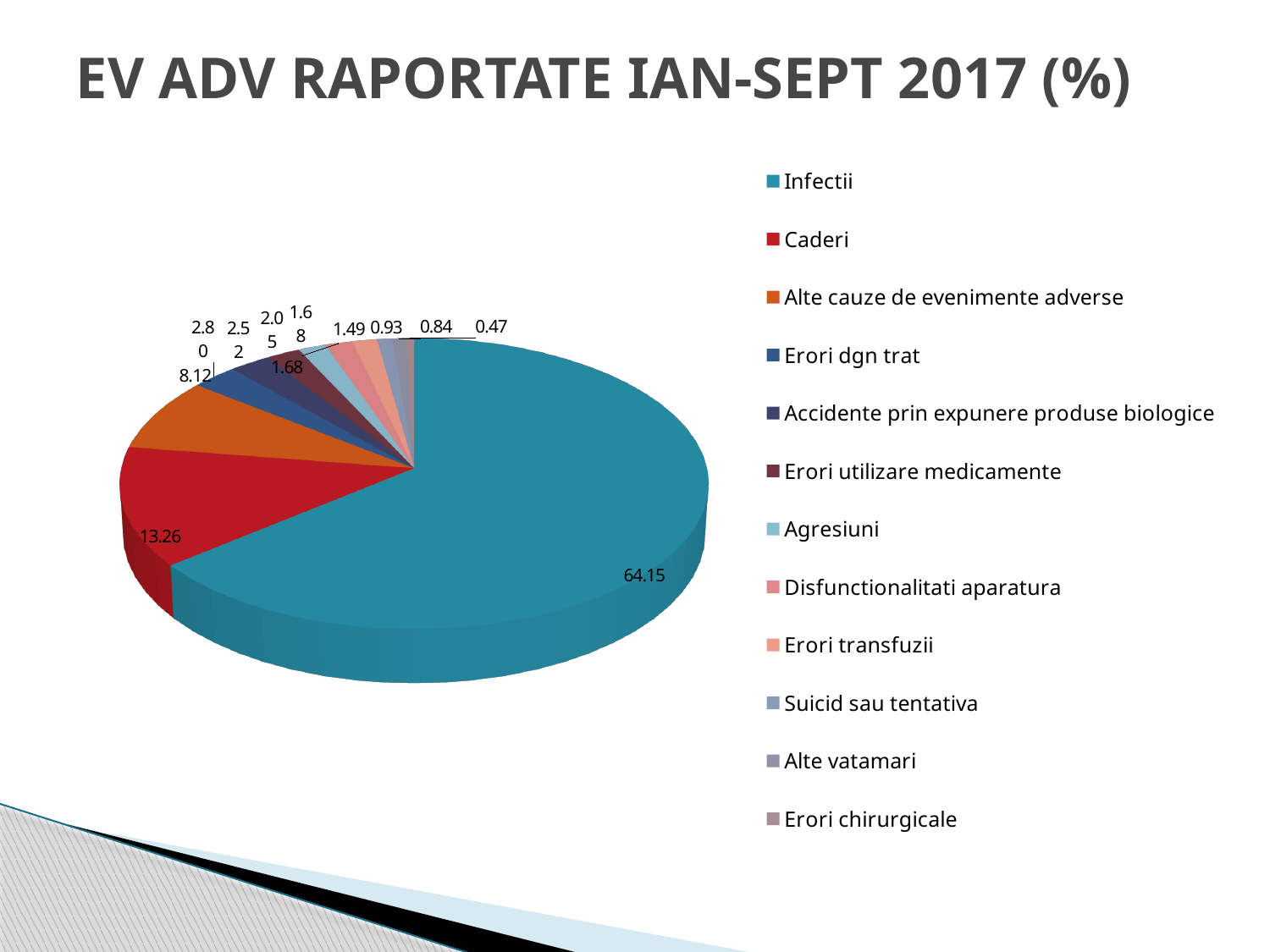
How many categories does the legend list? 12 What is the title of the chart? EV ADV RAPORTATE IAN-SEPT 2017 (%) What is the difference between the values for Infectii and Caderi? 50.89 What is the smallest value labelled on the pie chart? 0.47 What is the value shown for Infectii? 64.15 What is the value shown for Caderi? 13.26 What share of the pie does Infectii represent? 64.15% Which legend entry is listed last? Erori chirurgicale What is the value shown for Alte cauze de evenimente adverse? 8.12 Which category has the largest slice of the pie? Infectii What type of chart is shown on the slide? pie chart Which is larger, the value for Caderi or the value for Alte cauze de evenimente adverse? Caderi